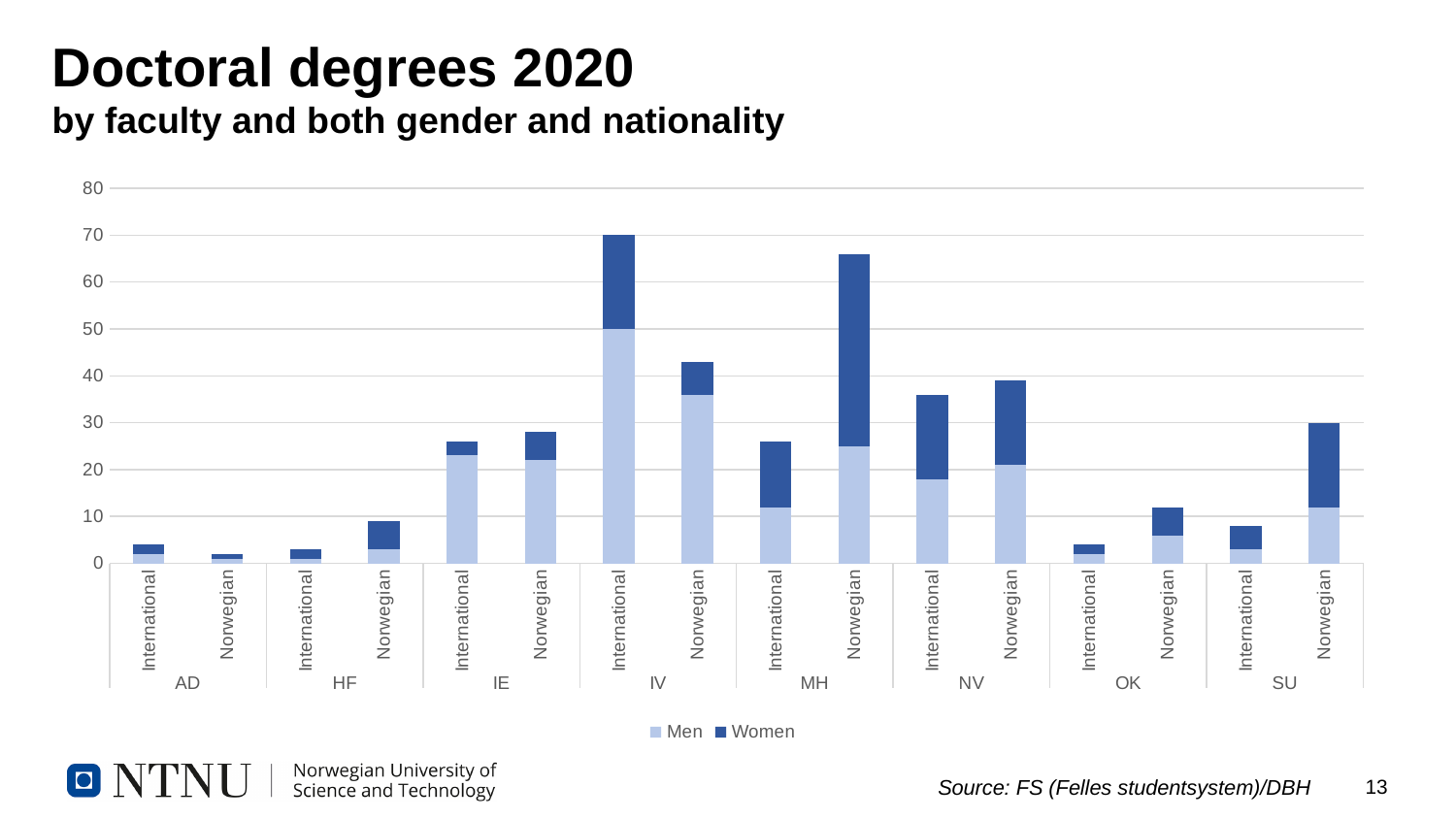
Which bar has the lowest total? AD Norwegian What kind of chart is shown on the slide? Stacked bar chart How many series does the legend list? 2 What are the two series named in the legend? Men and Women Is the total for OK International greater or less than 10? less Which bar has the highest total? IV International Is the total for MH Norwegian greater or less than 60? greater What is the total of the SU Norwegian bar? 30 How many bars are plotted in the chart? 16 What is the total of the IV International bar? 70 Which is larger, the total for NV International or the total for IE Norwegian? NV International How many faculties are shown along the x axis? 8